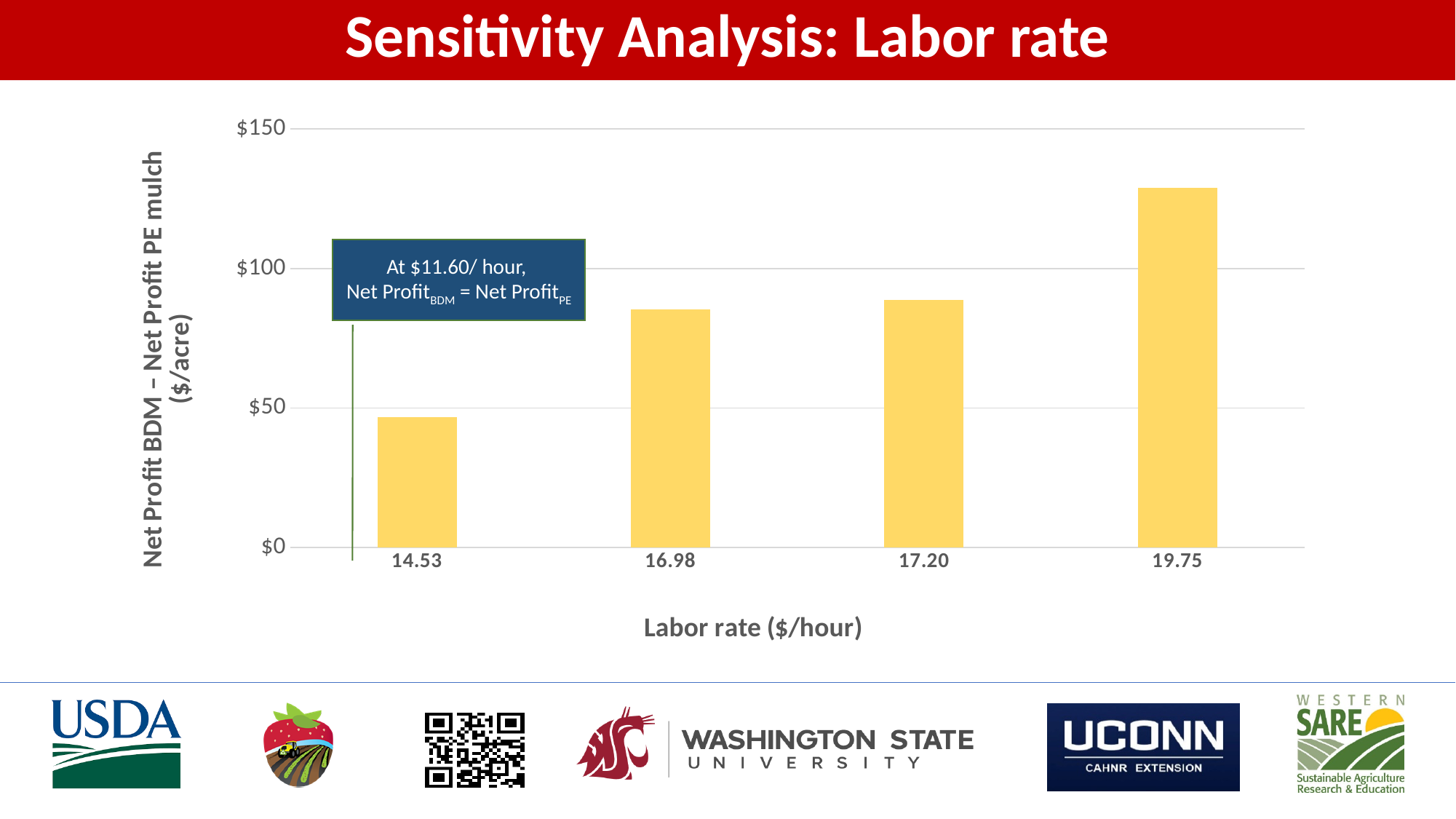
Is the value for the 16.98 labor rate greater or less than $100? less What is the title of the x axis? Labor rate ($/hour) Which labor rate has the highest bar? 19.75 Which labor rate has the lowest bar? 14.53 Is the value for the 14.53 labor rate greater or less than $50? less What kind of chart is shown on the slide? bar chart How many labor rate categories are plotted on the chart? 4 Do the bar values rise or fall as the labor rate increases along the x axis? rise Which has the larger value, the 14.53 labor rate or the 19.75 labor rate? 19.75 According to the annotation box, at what labor rate does Net Profit BDM equal Net Profit PE? $11.60/ hour Is the value for the 19.75 labor rate greater or less than $100? greater